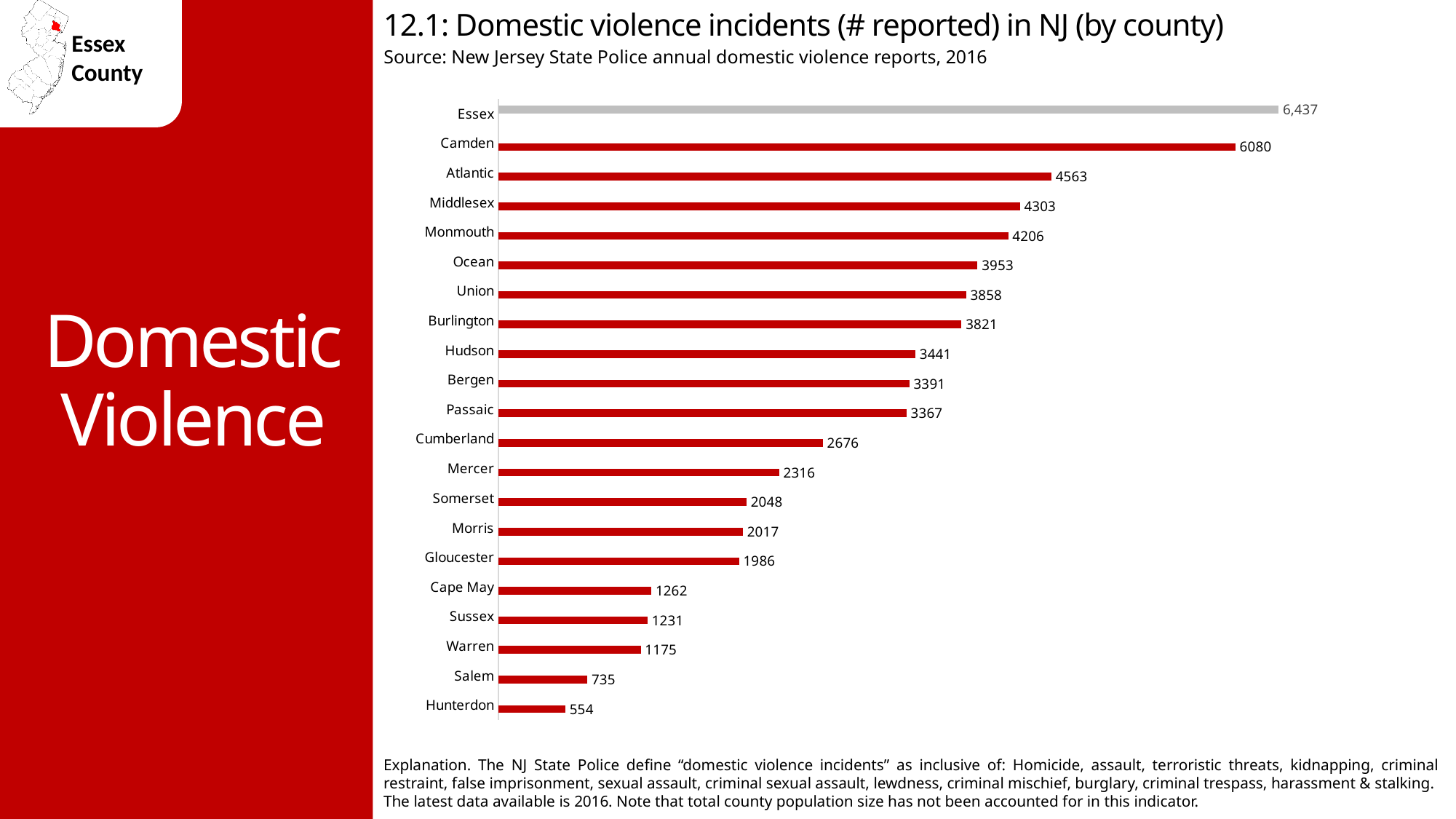
What is the value shown for Hudson county? 3441 What is the difference between the values for Essex and Camden? 357 How many incidents were reported in Cape May county? 1262 Which county has the lowest number of reported domestic violence incidents? Hunterdon How many counties are shown in the chart? 21 What is the difference between the values for Salem and Hunterdon? 181 How many domestic violence incidents were reported in Camden county? 6080 Which county's bar is coloured grey instead of red? Essex Which county has the highest number of reported domestic violence incidents? Essex Which county has more reported incidents, Mercer or Cumberland? Cumberland Which county has more reported incidents, Atlantic or Middlesex? Atlantic What kind of chart is shown on the slide? Bar chart